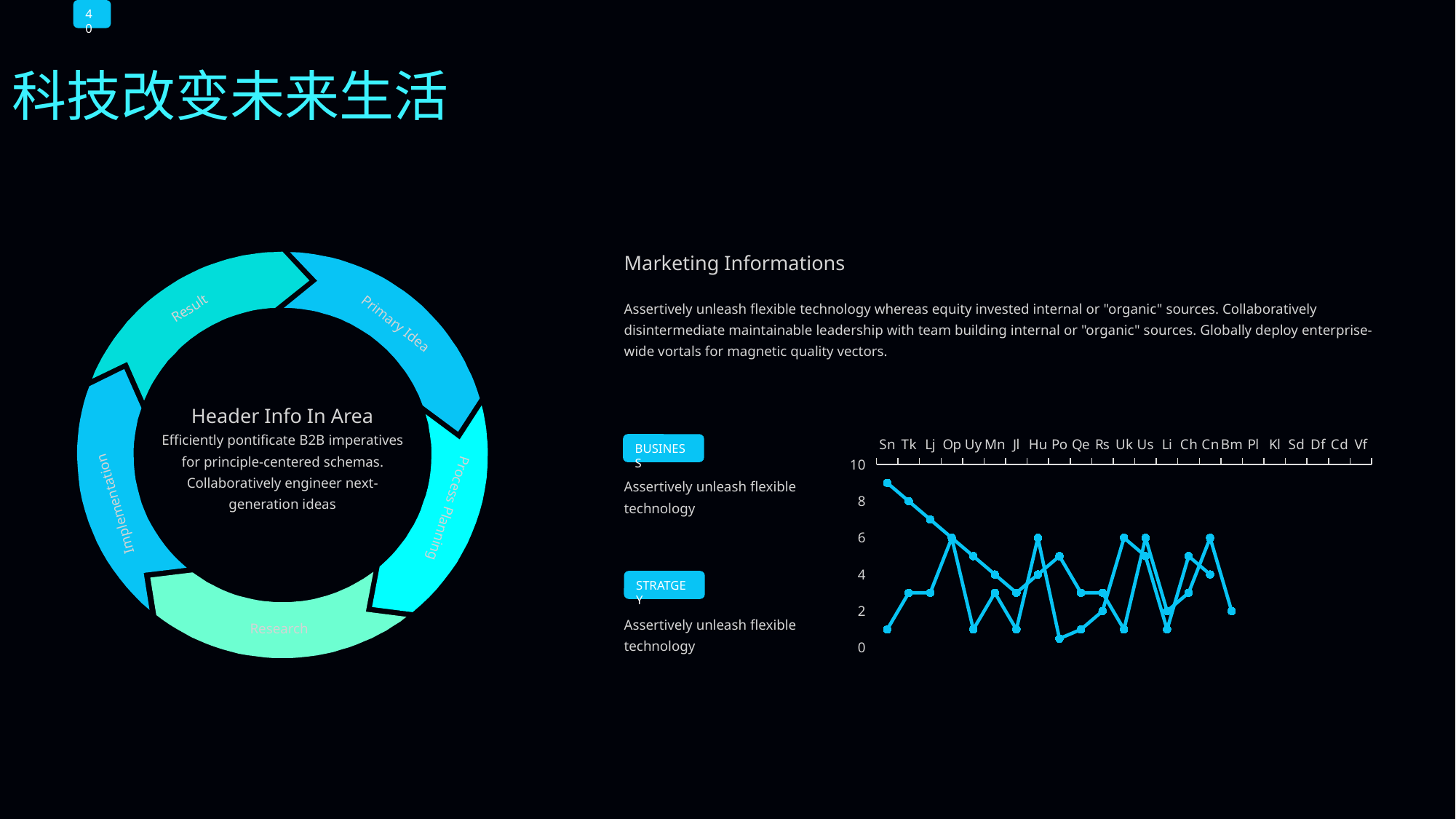
How many lines are plotted on the line chart? 2 Does the line chart have a legend? No Is the higher of the two values at Sn greater or less than 8? greater Is the lower of the two values at Sn greater or less than 2? less Is the highest value plotted on the line chart greater or less than 8? greater What is the first category label on the x axis of the line chart? Sn What kind of chart is shown on the right side of the slide? line chart What is the last category label on the x axis of the line chart? Vf Does the line that starts highest at Sn rise or fall from Sn to Op? fall How many categories are listed along the x axis of the line chart? 23 What is the highest tick value shown on the y axis of the line chart? 10